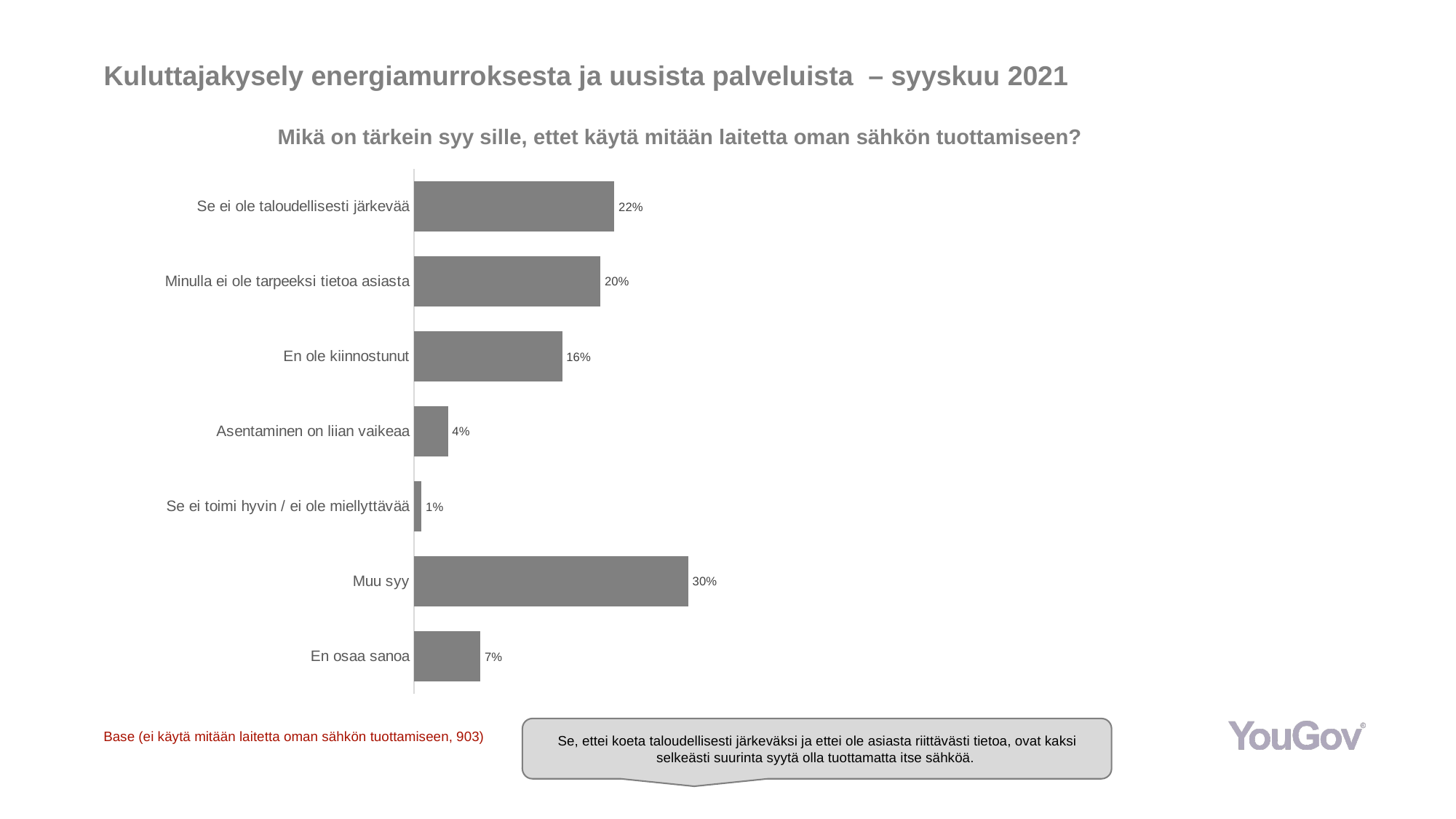
Which is larger, the value for "En ole kiinnostunut" or the value for "En osaa sanoa"? En ole kiinnostunut What kind of chart is shown on the slide? Bar chart Which category has the lowest value? Se ei toimi hyvin / ei ole miellyttävää What is the difference between the values for "Muu syy" and "Se ei ole taloudellisesti järkevää"? 8% What is the value for "Minulla ei ole tarpeeksi tietoa asiasta"? 20% What is the value for "Asentaminen on liian vaikeaa"? 4% What is the title of the chart? Mikä on tärkein syy sille, ettet käytä mitään laitetta oman sähkön tuottamiseen? What is the difference between the values for "En ole kiinnostunut" and "Asentaminen on liian vaikeaa"? 12% What is the value for "En osaa sanoa"? 7% Which category has the highest value? Muu syy How many categories are shown in the chart? 7 What is the value for "Se ei ole taloudellisesti järkevää"? 22%